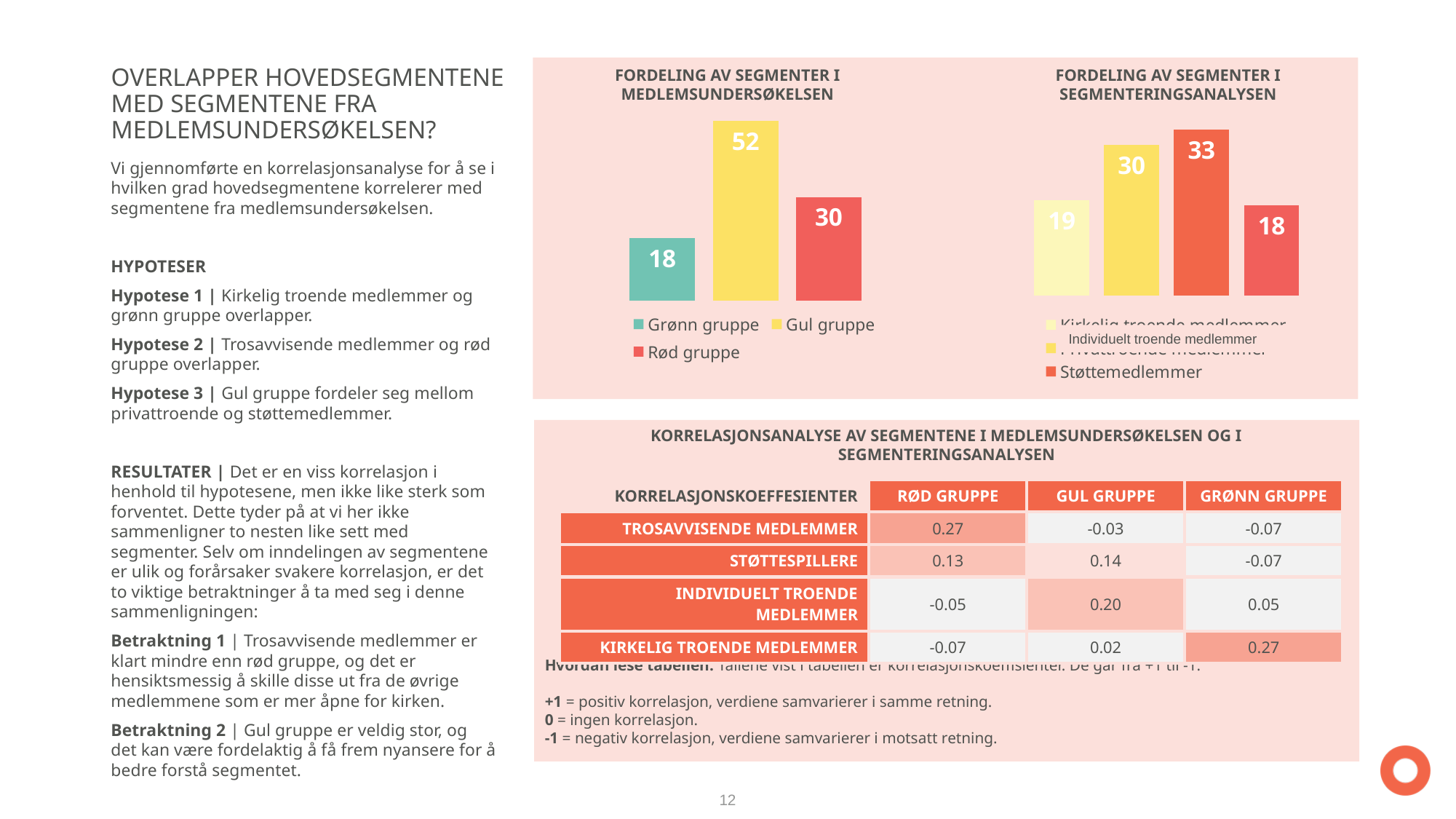
In the chart titled 'Fordeling av segmenter i segmenteringsanalysen', what is the highest value shown on a bar? 33 In the chart titled 'Fordeling av segmenter i segmenteringsanalysen', how many bars are plotted? 4 In the chart titled 'Fordeling av segmenter i medlemsundersøkelsen', what is the difference between Gul gruppe and Rød gruppe? 22 In the chart titled 'Fordeling av segmenter i medlemsundersøkelsen', what is the value for Gul gruppe? 52 In the chart titled 'Fordeling av segmenter i medlemsundersøkelsen', how many series does the legend list? 3 What kind of chart is 'Fordeling av segmenter i segmenteringsanalysen'? Bar chart In the chart titled 'Fordeling av segmenter i segmenteringsanalysen', what is the value of the first (leftmost) bar? 19 In the chart titled 'Fordeling av segmenter i medlemsundersøkelsen', which group has the highest value? Gul gruppe In the chart titled 'Fordeling av segmenter i medlemsundersøkelsen', which group has the lowest value? Grønn gruppe In the chart titled 'Fordeling av segmenter i medlemsundersøkelsen', what is the value for Grønn gruppe? 18 In the chart titled 'Fordeling av segmenter i medlemsundersøkelsen', what is the value for Rød gruppe? 30 In the chart titled 'Fordeling av segmenter i segmenteringsanalysen', what is the lowest value shown on a bar? 18